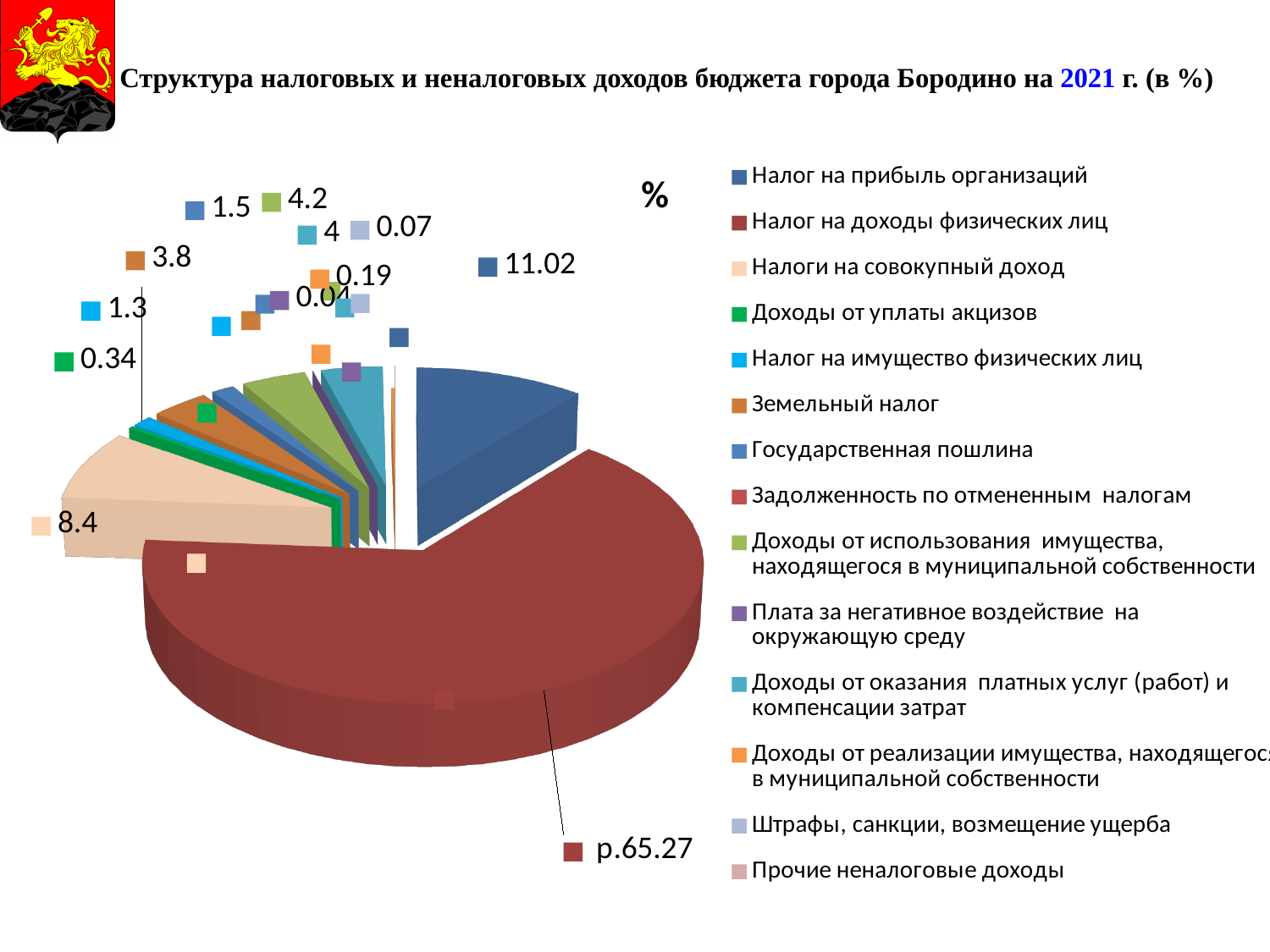
How many entries does the legend list? 14 Which category has the largest share of the pie? Налог на доходы физических лиц What value is shown for Налоги на совокупный доход? 8.4 What kind of chart is shown on the slide? pie chart What value is shown for Налог на имущество физических лиц? 1.3 What value is shown for Земельный налог? 3.8 Which year does the chart title refer to? 2021 What value is shown for Налог на прибыль организаций? 11.02 What value is shown for Доходы от уплаты акцизов? 0.34 What value is shown for Государственная пошлина? 1.5 Which is larger: Налог на прибыль организаций or Налоги на совокупный доход? Налог на прибыль организаций What is the difference between the values for Налог на прибыль организаций and Налоги на совокупный доход? 2.62